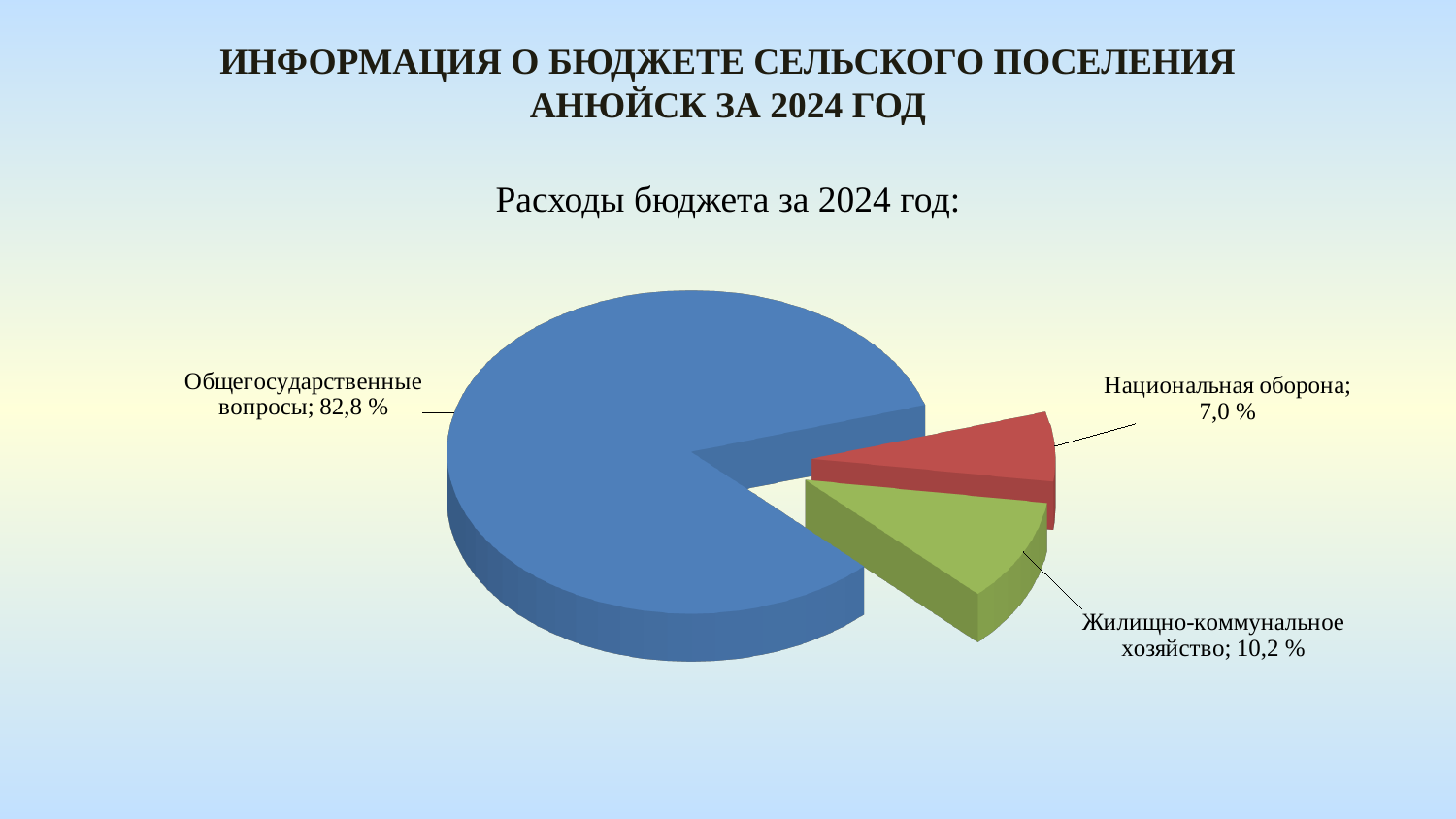
How many categories are shown in the pie chart? 3 Which category has the smallest share of the pie? Национальная оборона What is the difference between the shares of Жилищно-коммунальное хозяйство and Национальная оборона? 3,2 % Which is larger: the share for Жилищно-коммунальное хозяйство or the share for Национальная оборона? Жилищно-коммунальное хозяйство Which category has the largest share of the pie? Общегосударственные вопросы What kind of chart is shown on the slide? Pie chart What share of the pie does Общегосударственные вопросы have? 82,8 % What is the title of the chart? Расходы бюджета за 2024 год: What share of the pie does Жилищно-коммунальное хозяйство have? 10,2 % What colour is the slice for Национальная оборона? Red What is the difference between the shares of Общегосударственные вопросы and Жилищно-коммунальное хозяйство? 72,6 % What share of the pie does Национальная оборона have? 7,0 %